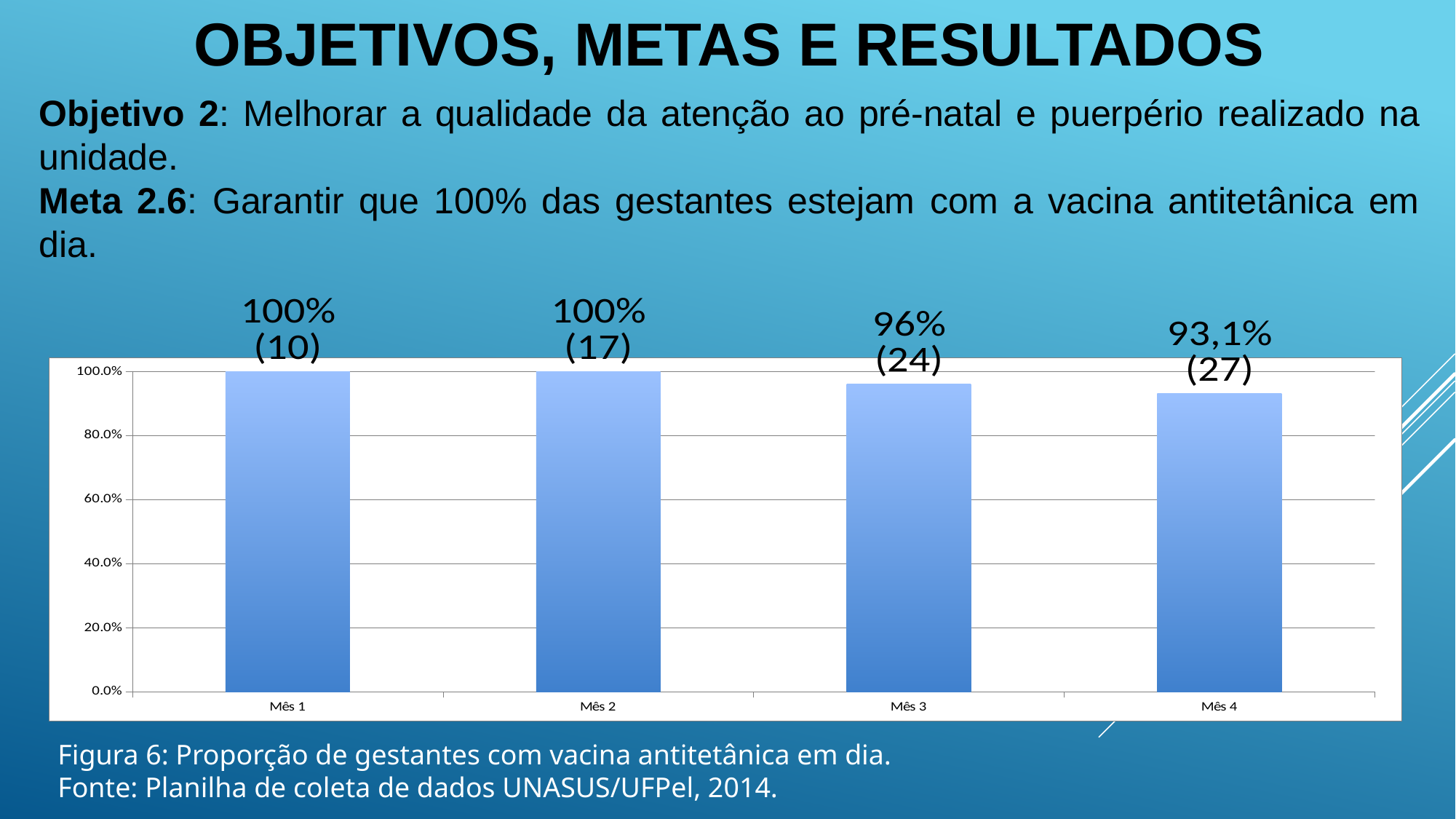
What is the value shown for Mês 1? 100% Which month has the lowest value? Mês 4 Is the value for Mês 4 greater or less than 80.0%? greater What kind of chart is shown on the slide? bar chart What is the value shown for Mês 3? 96% What number is shown in parentheses above the bar for Mês 2? 17 What is the difference between the values for Mês 1 and Mês 3? 4% What is the value shown for Mês 4? 93,1% What is the caption (figure title) given below the chart? Figura 6: Proporção de gestantes com vacina antitetânica em dia. Do the values rise or fall from Mês 2 to Mês 4? fall How many months are shown on the x axis? 4 Which is larger, the value for Mês 3 or the value for Mês 4? Mês 3